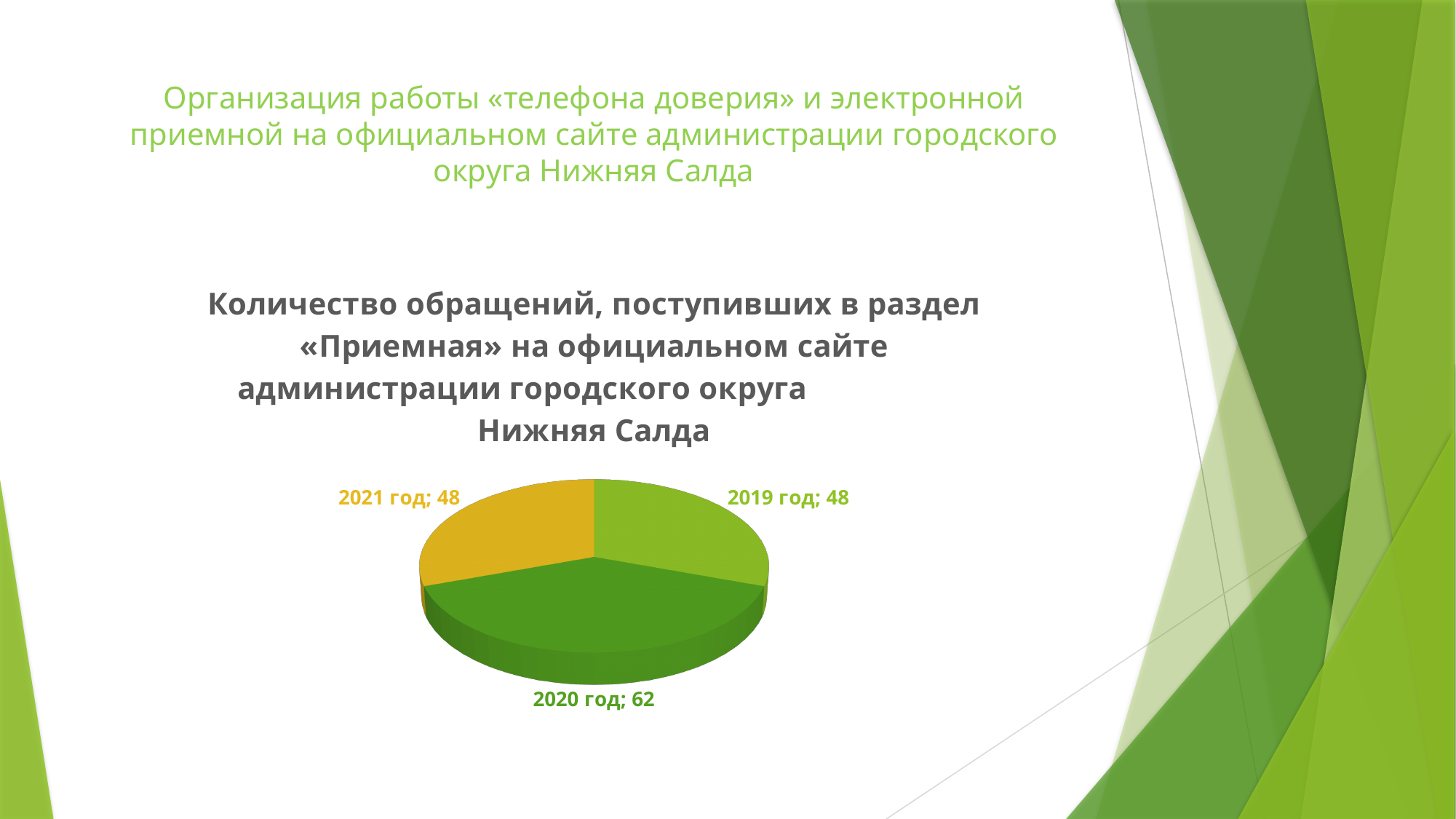
What kind of chart is shown on the slide? pie chart Which is larger, the value for 2020 год or the value for 2021 год? 2020 год What is the total of all values shown in the pie chart? 158 What is the value for 2021 год in the pie chart? 48 What is the difference between the values for 2020 год and 2019 год? 14 What colour is the 2021 год slice in the pie chart? yellow Which year has the highest value in the pie chart? 2020 год How many slices does the pie chart have? 3 What is the value for 2020 год in the pie chart? 62 What is the difference between the values for 2020 год and 2021 год? 14 What is the value for 2019 год in the pie chart? 48